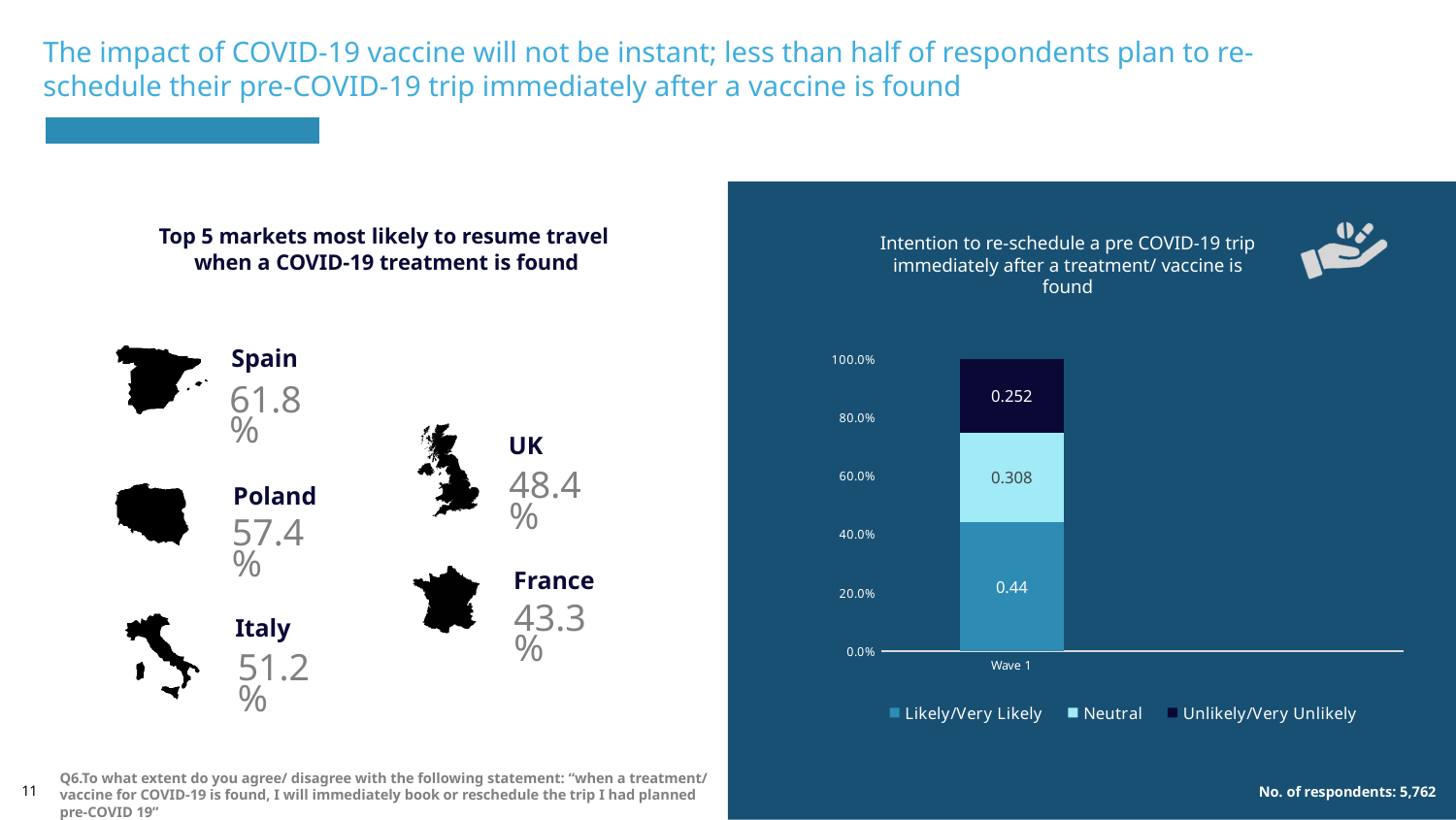
What is the difference between the Likely/Very Likely value and the Unlikely/Very Unlikely value in Wave 1? 0.188 Which series has the smallest segment in the Wave 1 bar? Unlikely/Very Unlikely How many series does the chart legend list? 3 What is the total of the three segments in the Wave 1 bar? 1 Which is larger in Wave 1: the Neutral value or the Unlikely/Very Unlikely value? Neutral In the chart, what is the value shown for Likely/Very Likely in Wave 1? 0.44 Which series has the largest segment in the Wave 1 bar? Likely/Very Likely How many categories are shown on the x axis of the chart? 1 What is the difference between the Neutral value and the Unlikely/Very Unlikely value in Wave 1? 0.056 In the chart, what is the value shown for Neutral in Wave 1? 0.308 What kind of chart is shown on the slide? Stacked bar chart In the chart, what is the value shown for Unlikely/Very Unlikely in Wave 1? 0.252